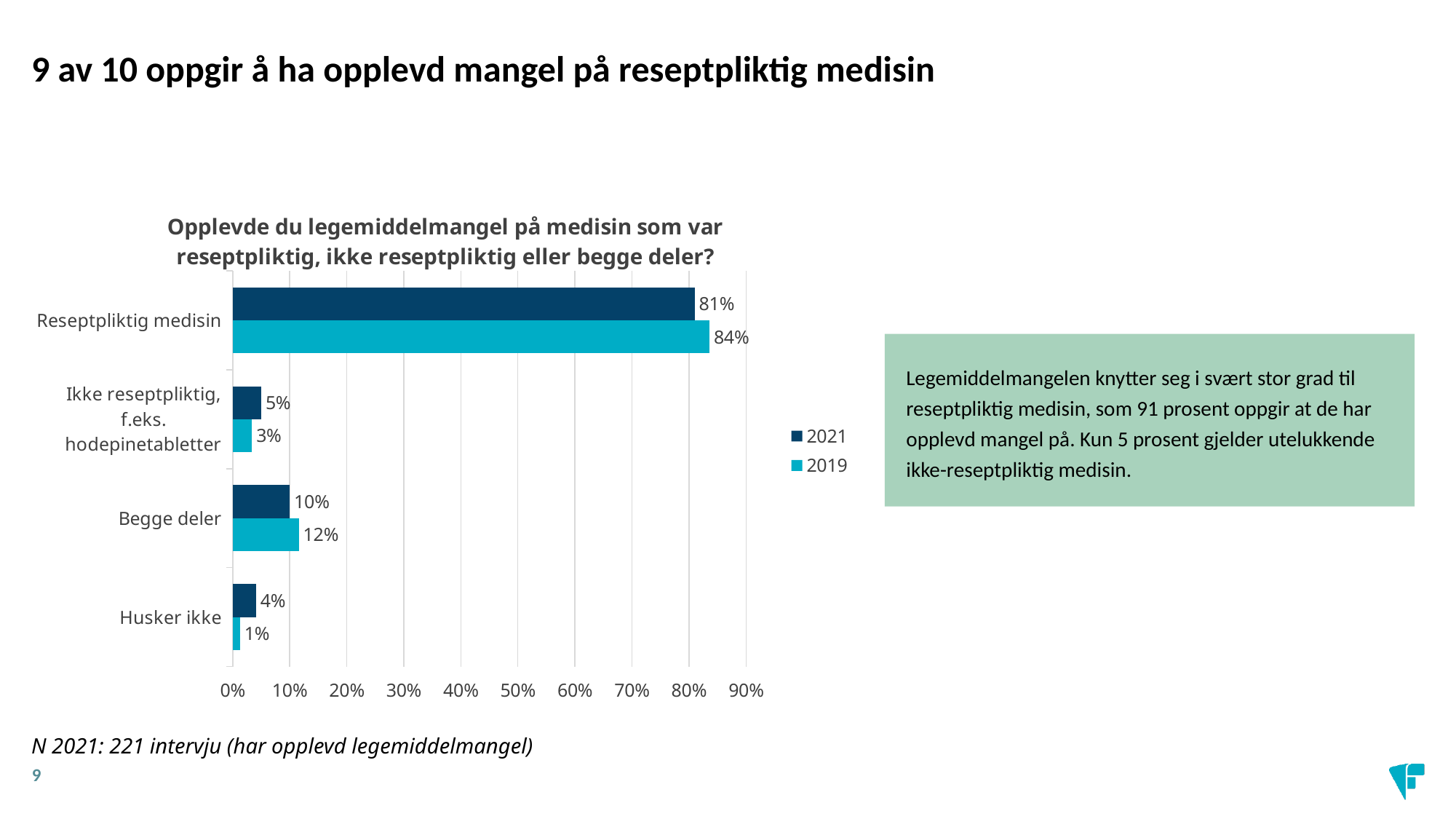
Which category has the highest value in the 2019 series? Reseptpliktig medisin Which category has the lowest value in the 2019 series? Husker ikke What is the 2019 value for Begge deler? 12% What kind of chart is shown on the slide? Bar chart What is the 2019 value for Ikke reseptpliktig, f.eks. hodepinetabletter? 3% How many series does the legend list? 2 How many categories are shown on the chart? 4 Which series is shown in the dark blue colour? 2021 What is the 2021 value for Husker ikke? 4% Which is larger for Begge deler: the 2021 value or the 2019 value? 2019 What is the difference between the 2019 and 2021 values for Reseptpliktig medisin? 3 percentage points What is the 2021 value for Reseptpliktig medisin? 81%